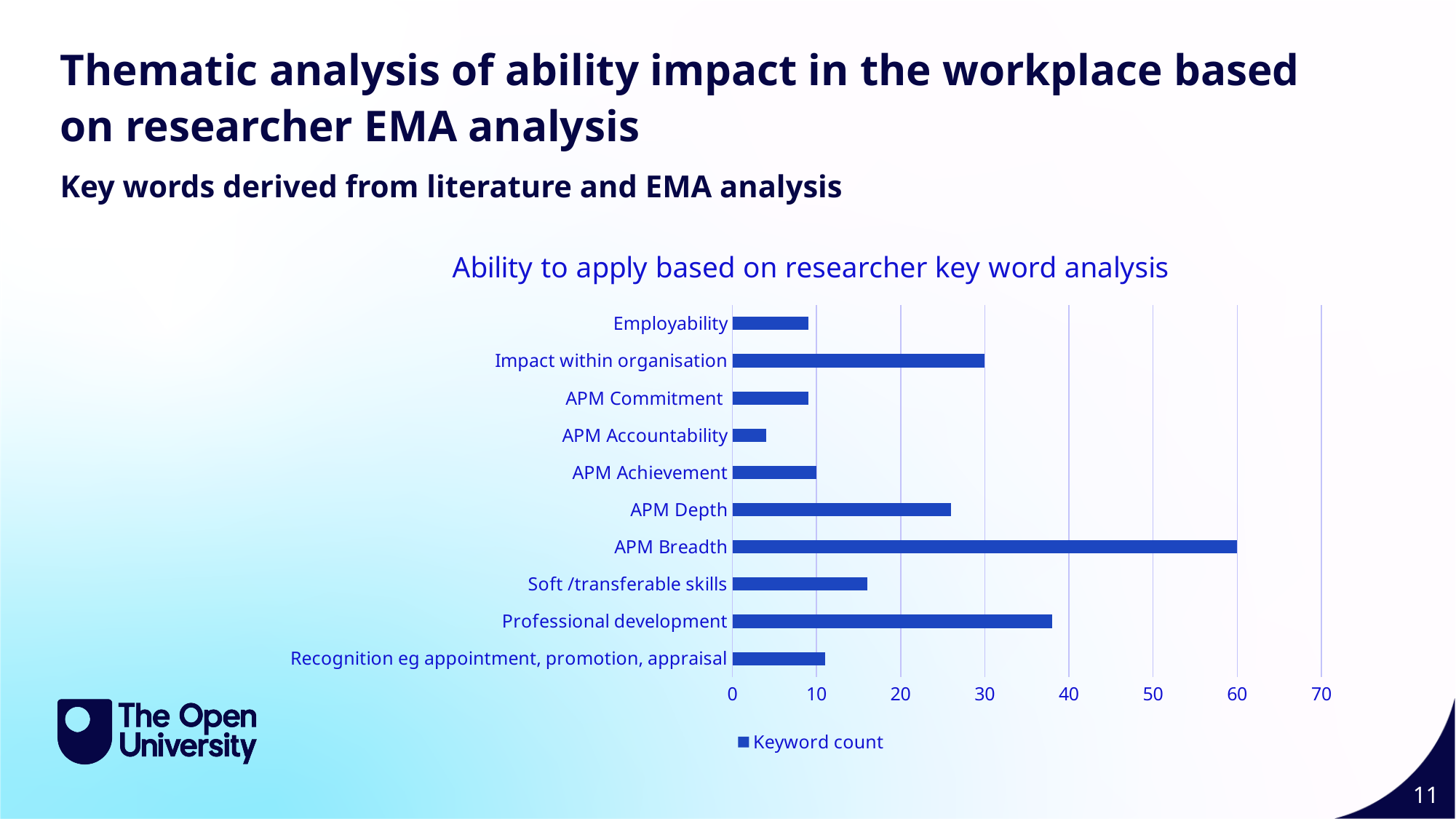
What is the legend entry for the series in the chart? Keyword count Which has a larger keyword count, Professional development or APM Depth? Professional development Which category has the lowest keyword count? APM Accountability What kind of chart is shown on the slide? bar chart How many categories are plotted in the chart? 10 What is the keyword count for Impact within organisation? 30 Is the value for Soft /transferable skills greater or less than 20? less Which category has the highest keyword count? APM Breadth Is the value for Professional development greater or less than 30? greater What is the title of the chart? Ability to apply based on researcher key word analysis How many series does the chart legend list? 1 What is the keyword count for APM Breadth? 60